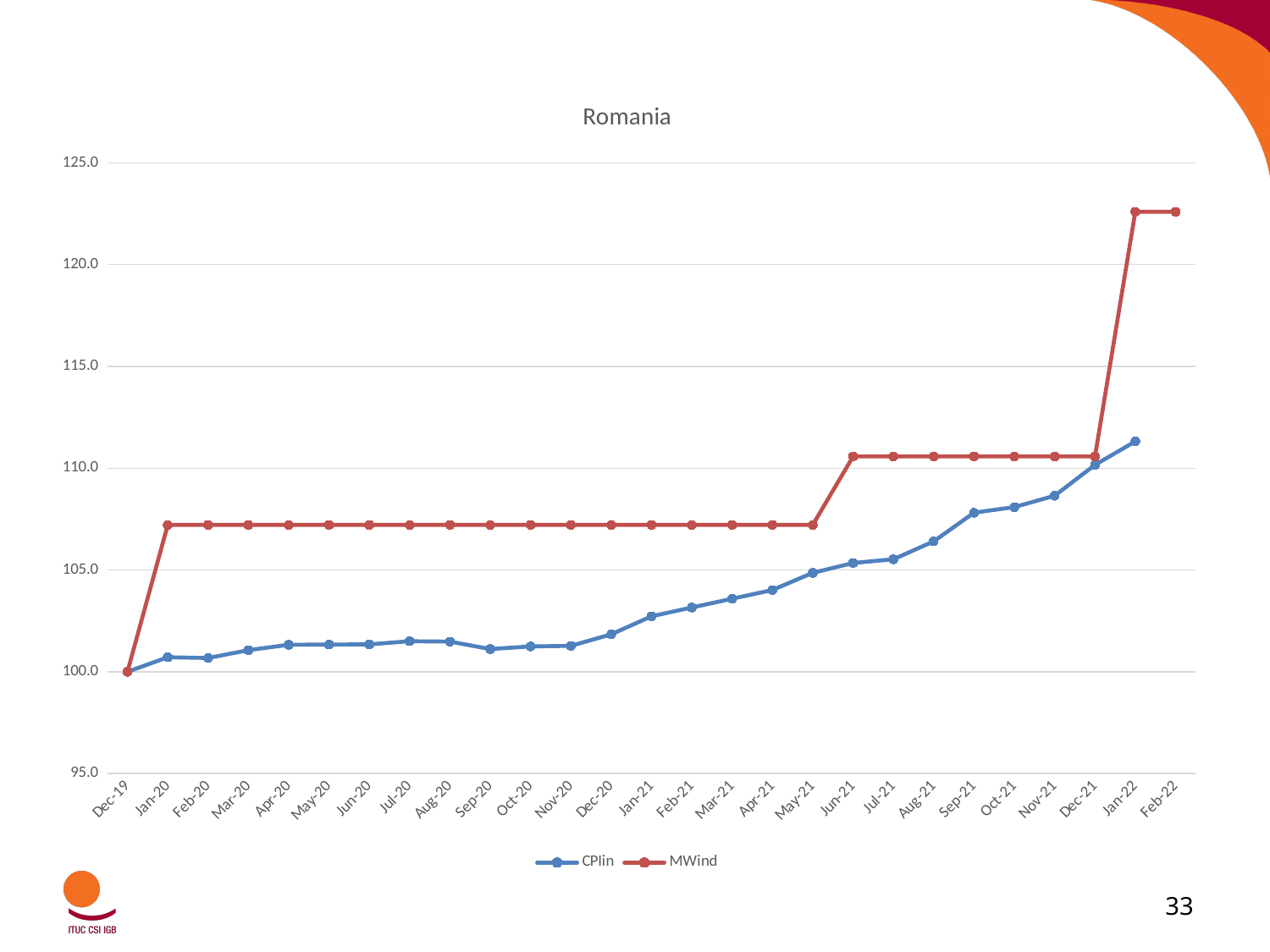
Is the value for MWind in Jan-20 greater or less than 105? greater What is the value of CPIin in Dec-19? 100.0 What is the value of MWind in Dec-19? 100.0 What is the title of the chart? Romania In which month is CPIin at its lowest? Dec-19 In Jan-22, which series has the larger value, CPIin or MWind? MWind How many series does the legend list? 2 What kind of chart is shown on the slide? line chart Is the value for CPIin in Feb-21 greater or less than 105? less Is the value for CPIin in Jan-22 greater or less than 110? greater How many months are shown on the x axis? 27